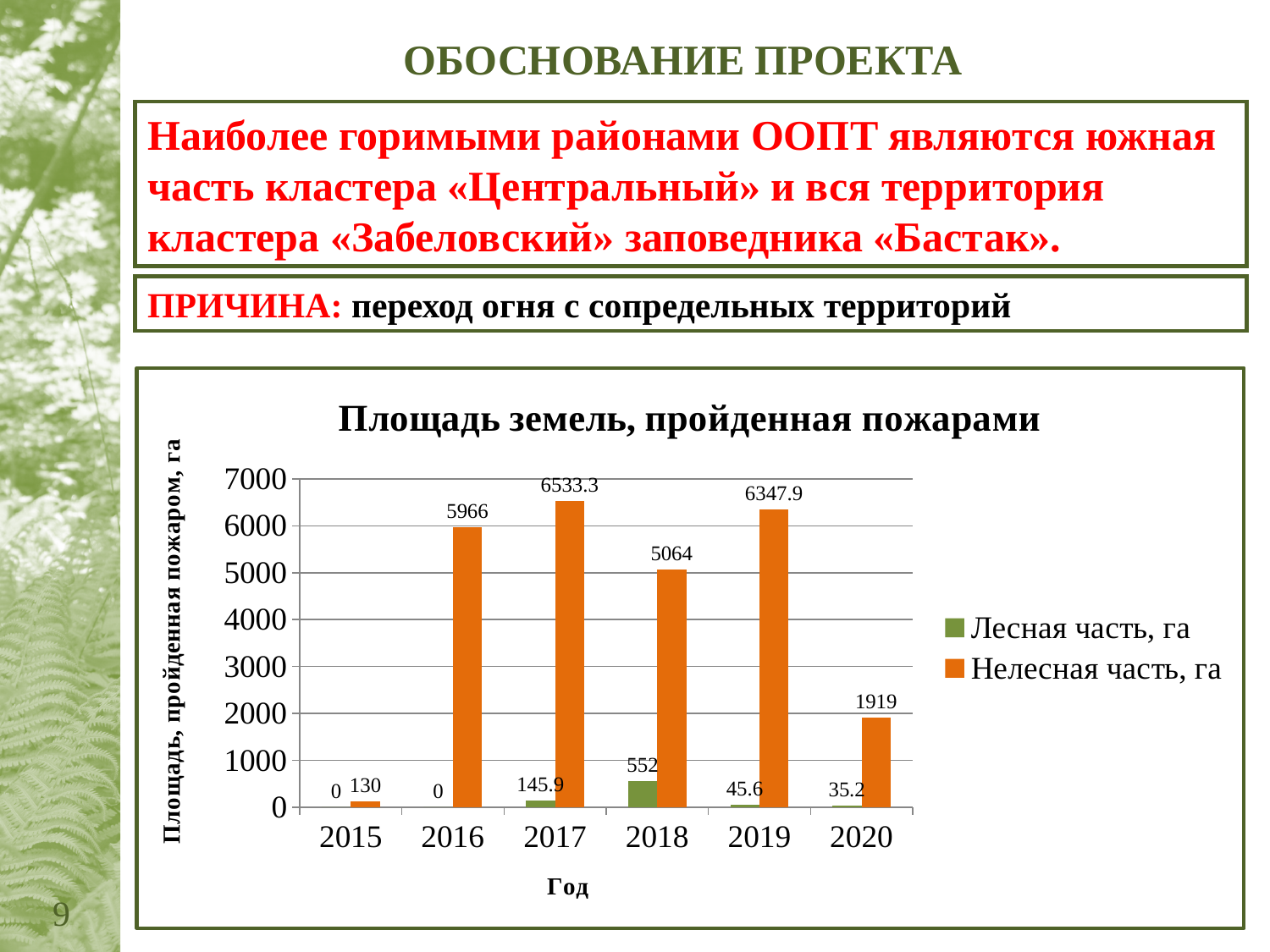
What is the value for Лесная часть, га in 2018? 552 What is the difference between the Нелесная часть, га values for 2016 and 2020? 4047 In which year is the value for Лесная часть, га the highest? 2018 Which year has the lowest value for Нелесная часть, га? 2015 What is the value for Лесная часть, га in 2019? 45.6 What is the value for Нелесная часть, га in 2017? 6533.3 What type of chart is shown on the slide? Bar chart How many years are shown on the x axis? 6 In which year is the value for Нелесная часть, га the highest? 2017 How many series does the legend list? 2 What is the value for Нелесная часть, га in 2020? 1919 Which is larger: the Нелесная часть, га value for 2018 or for 2019? 2019